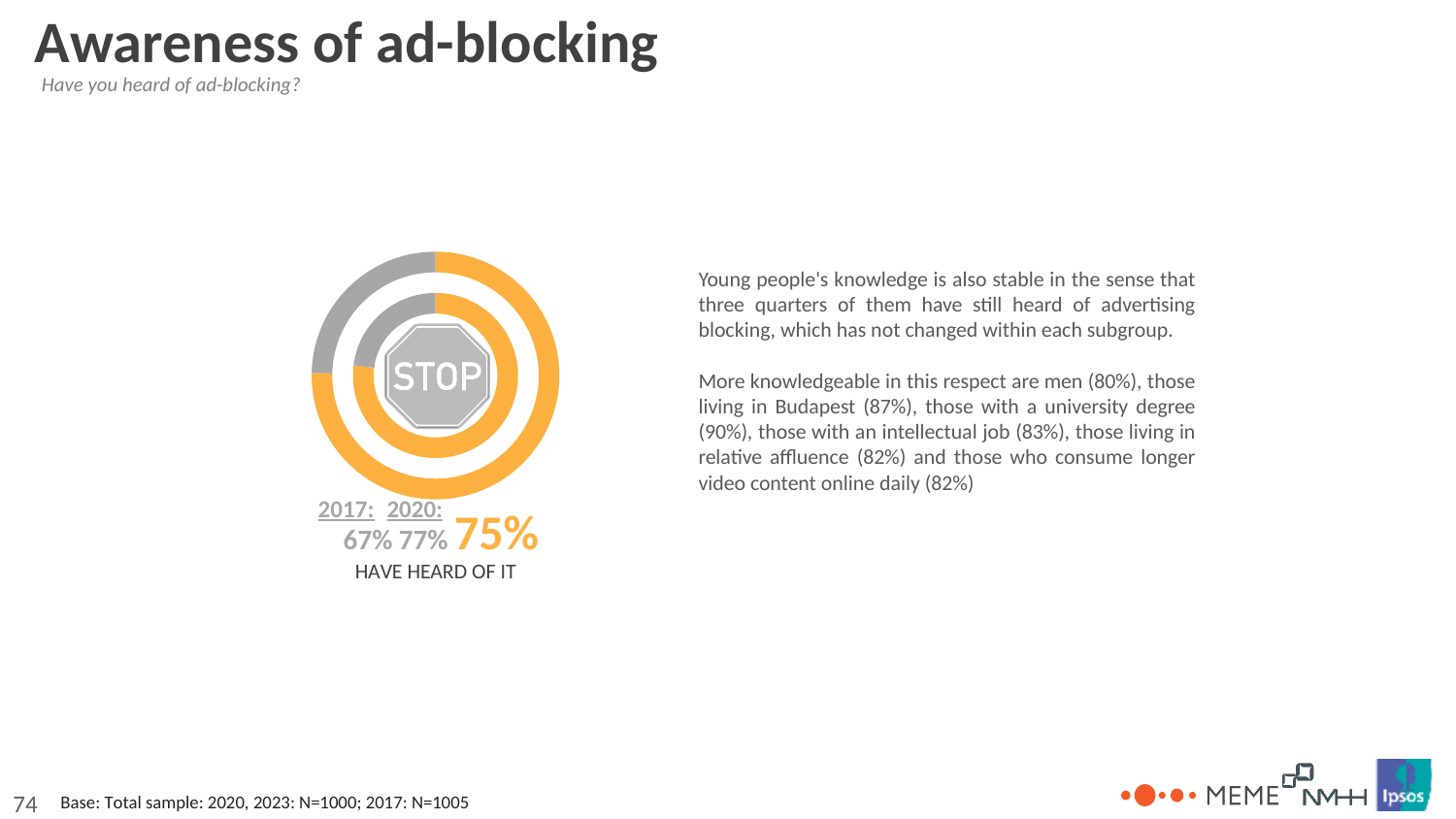
What is the large orange percentage shown next to the 2017 and 2020 values on the chart? 75% How many concentric rings does the doughnut chart have? 3 What kind of chart is used to show awareness of ad-blocking on this slide? doughnut chart What caption appears directly below the percentages on the chart? HAVE HEARD OF IT Which year shown on the chart has the higher share of people who have heard of ad-blocking, 2017 or 2020? 2020 What percentage of respondents had heard of ad-blocking in 2017? 67% What percentage of respondents had heard of ad-blocking in 2020? 77% Did awareness of ad-blocking rise or fall between 2017 and 2020? rise What is the title of the slide containing the chart? Awareness of ad-blocking Of the labelled years 2017 and 2020, which has the lowest awareness value? 2017 By how many percentage points did awareness of ad-blocking increase from 2017 to 2020? 10 percentage points